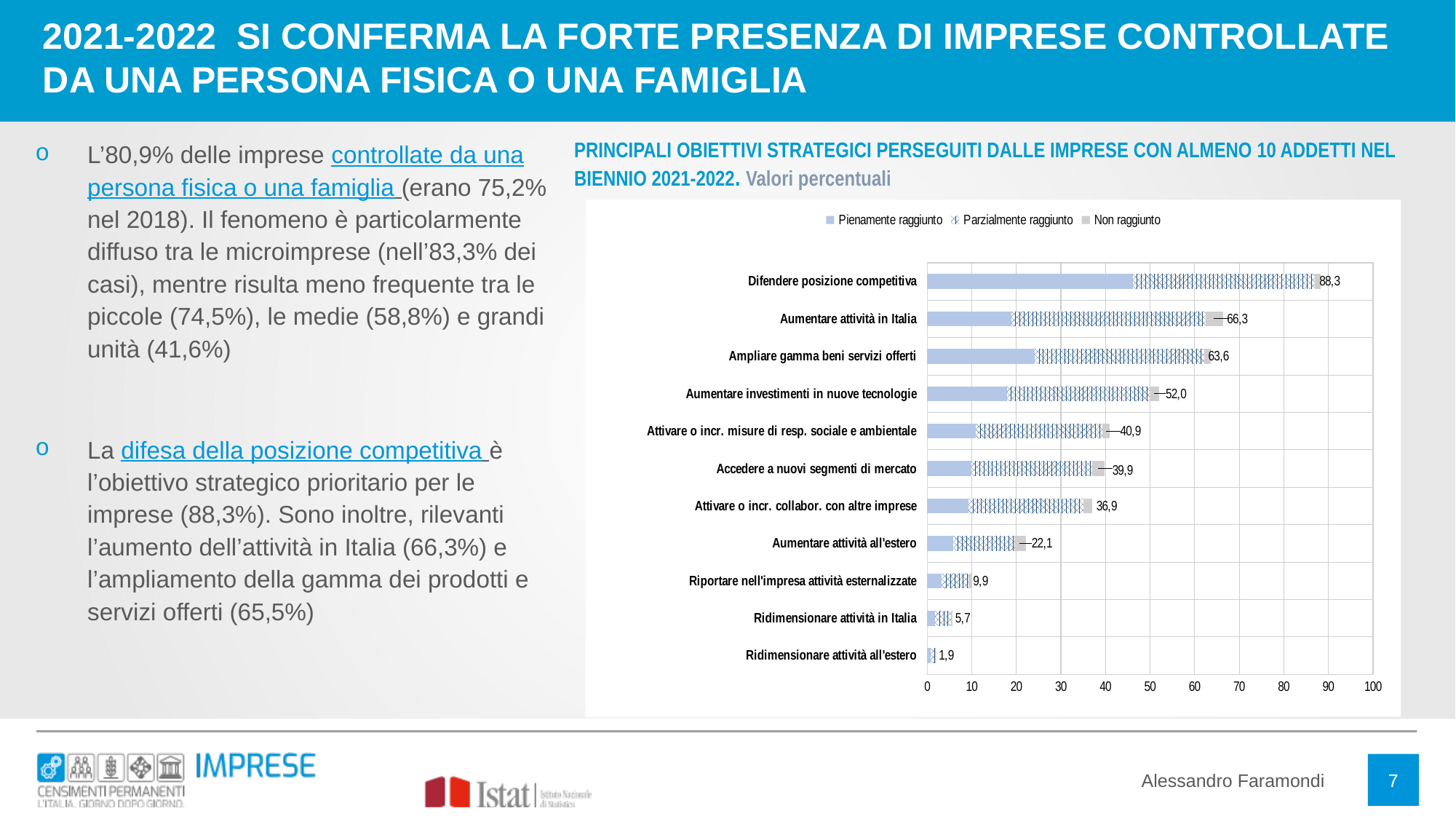
Which strategic objective has the highest total value? Difendere posizione competitiva Which strategic objective has the lowest total value? Ridimensionare attività all'estero How many series does the chart legend list? 3 What is the total value shown for "Difendere posizione competitiva"? 88,3 What type of chart is shown on the slide? Stacked bar chart How many strategic objectives are listed in the chart? 11 What is the total value shown for "Aumentare attività all'estero"? 22,1 What are the three series named in the chart legend? Pienamente raggiunto, Parzialmente raggiunto, Non raggiunto Is the "Pienamente raggiunto" value for "Difendere posizione competitiva" greater or less than 40? greater What is the total value shown for "Aumentare investimenti in nuove tecnologie"? 52,0 What is the difference between the total values for "Aumentare attività in Italia" and "Ampliare gamma beni servizi offerti"? 2,7 Which has a larger total value: "Attivare o incr. misure di resp. sociale e ambientale" or "Attivare o incr. collabor. con altre imprese"? Attivare o incr. misure di resp. sociale e ambientale